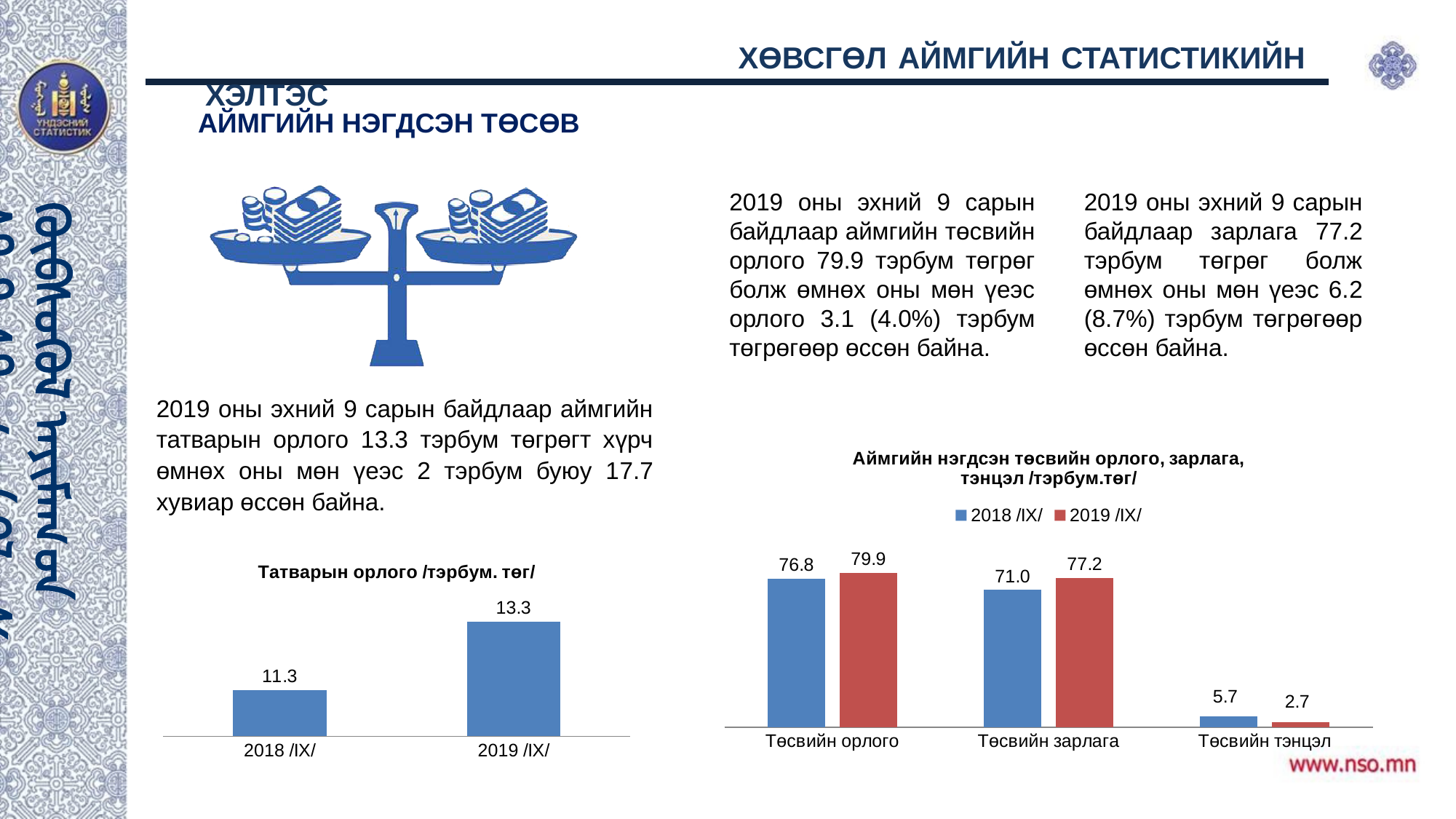
In the chart titled 'Аймгийн нэгдсэн төсвийн орлого, зарлага, тэнцэл /тэрбум.төг/', what is the 2018 /IX/ value for Төсвийн тэнцэл? 5.7 In the chart titled 'Аймгийн нэгдсэн төсвийн орлого, зарлага, тэнцэл /тэрбум.төг/', what is the difference between the 2019 /IX/ and 2018 /IX/ values for Төсвийн орлого? 3.1 In the chart titled 'Аймгийн нэгдсэн төсвийн орлого, зарлага, тэнцэл /тэрбум.төг/', which is larger for Төсвийн тэнцэл: the 2018 /IX/ value or the 2019 /IX/ value? 2018 /IX/ In the chart titled 'Татварын орлого /тэрбум. төг/', what is the value for 2019 /IX/? 13.3 In the chart titled 'Аймгийн нэгдсэн төсвийн орлого, зарлага, тэнцэл /тэрбум.төг/', what is the 2019 /IX/ value for Төсвийн зарлага? 77.2 In the chart titled 'Аймгийн нэгдсэн төсвийн орлого, зарлага, тэнцэл /тэрбум.төг/', how many series does the legend list? 2 What kind of chart is the one titled 'Татварын орлого /тэрбум. төг/'? bar chart In the chart titled 'Аймгийн нэгдсэн төсвийн орлого, зарлага, тэнцэл /тэрбум.төг/', which category has the lowest 2019 /IX/ value? Төсвийн тэнцэл In the chart titled 'Аймгийн нэгдсэн төсвийн орлого, зарлага, тэнцэл /тэрбум.төг/', how many categories are shown on the x axis? 3 In the chart titled 'Татварын орлого /тэрбум. төг/', what is the value for 2018 /IX/? 11.3 In the chart titled 'Татварын орлого /тэрбум. төг/', what is the difference between the 2019 /IX/ and 2018 /IX/ values? 2.0 In the chart titled 'Татварын орлого /тэрбум. төг/', do the values rise or fall from 2018 /IX/ to 2019 /IX/? rise